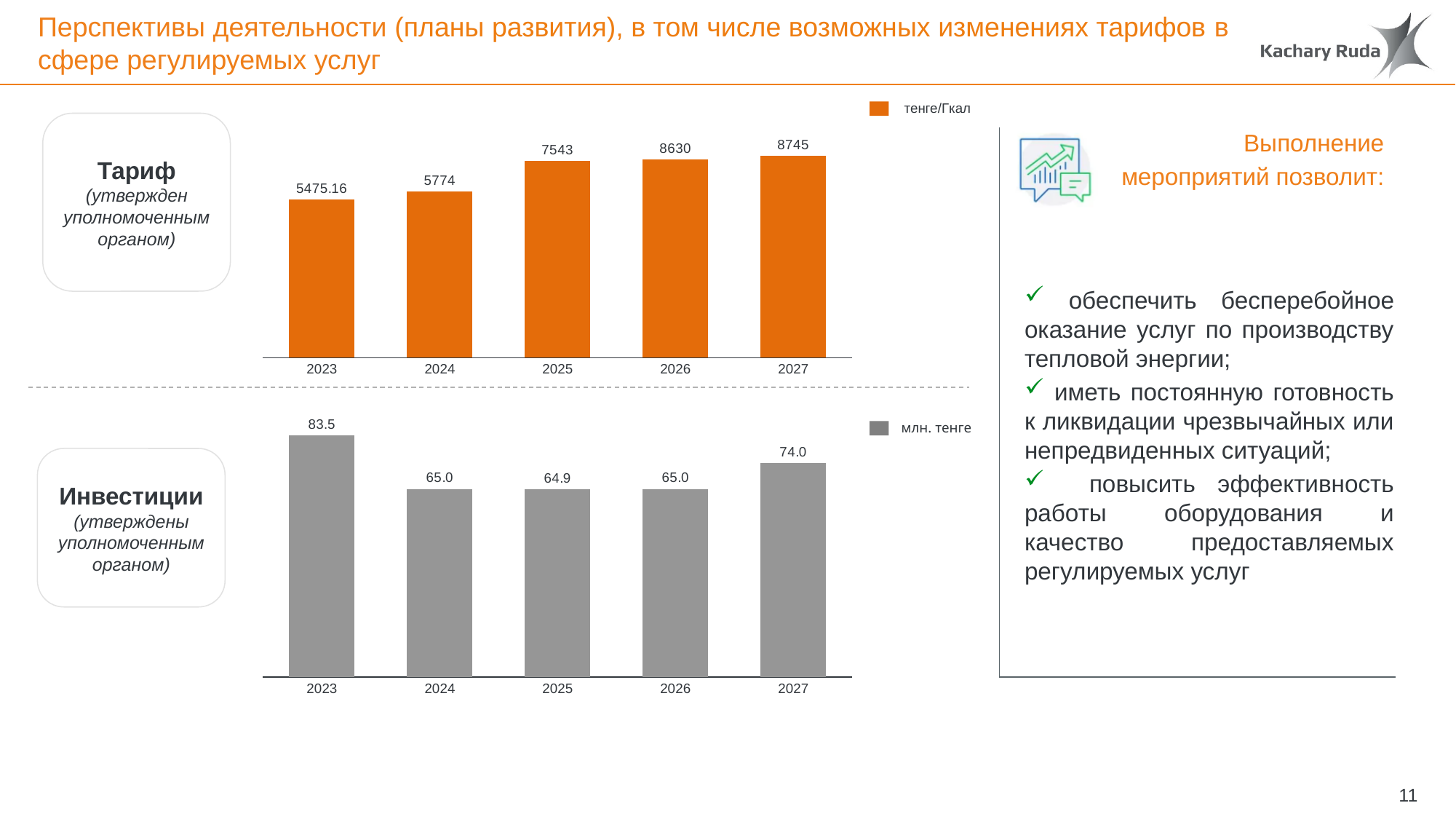
What type of chart is the bottom chart (Инвестиции)? bar chart In the bottom chart (Инвестиции), what is the difference between the values for 2023 and 2027? 9.5 In the bottom chart (Инвестиции), how many years are shown on the x axis? 5 In the top chart (Тариф), what unit does the legend show? тенге/Гкал In the bottom chart (Инвестиции), what is the value for 2027? 74.0 In the top chart (Тариф), what is the value for 2025? 7543 In the top chart (Тариф), what is the difference between the values for 2026 and 2024? 2856 In the bottom chart (Инвестиции), which year has the lowest value? 2025 In the top chart (Тариф), what is the value for 2023? 5475.16 In the bottom chart (Инвестиции), which year has the highest value? 2023 In the top chart (Тариф), do the values rise or fall from 2023 to 2027? rise In the top chart (Тариф), which year has the highest value? 2027